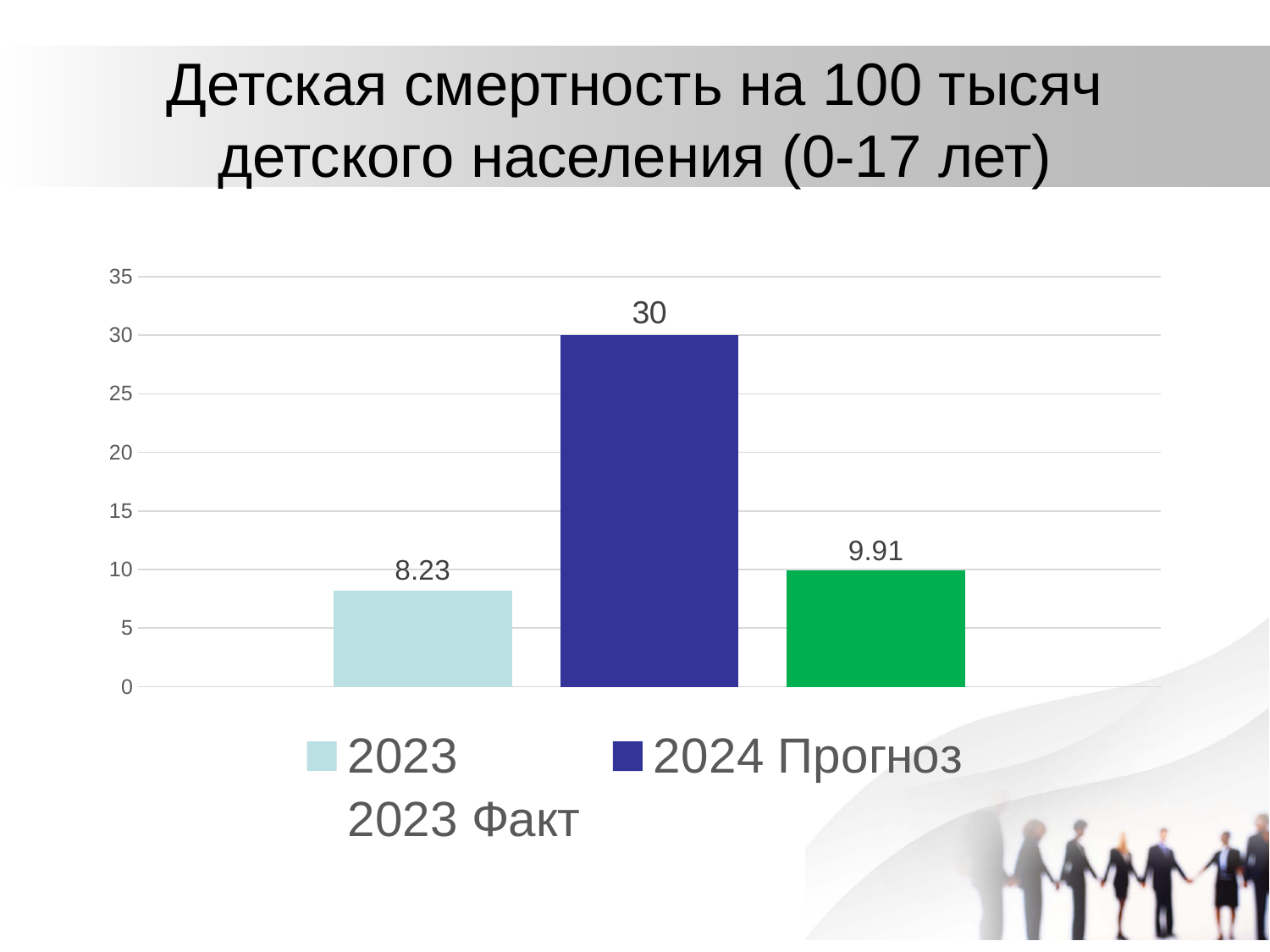
Is the value for 2024 Прогноз greater or less than 25? greater How many bars are plotted in the chart? 3 What is the value of the 2023 Факт bar (green)? 9.91 What is the value of the 2023 bar (light blue)? 8.23 What is the value of the 2024 Прогноз bar? 30 What is the difference between the 2023 Факт value and the 2023 value? 1.68 What is the difference between the 2024 Прогноз value and the 2023 Факт value? 20.09 Which series has the lowest value? 2023 What type of chart is shown on the slide? bar chart Which series has the highest value? 2024 Прогноз Which is larger, the 2023 Факт value or the 2023 value? 2023 Факт What is the title of the slide? Детская смертность на 100 тысяч детского населения (0-17 лет)